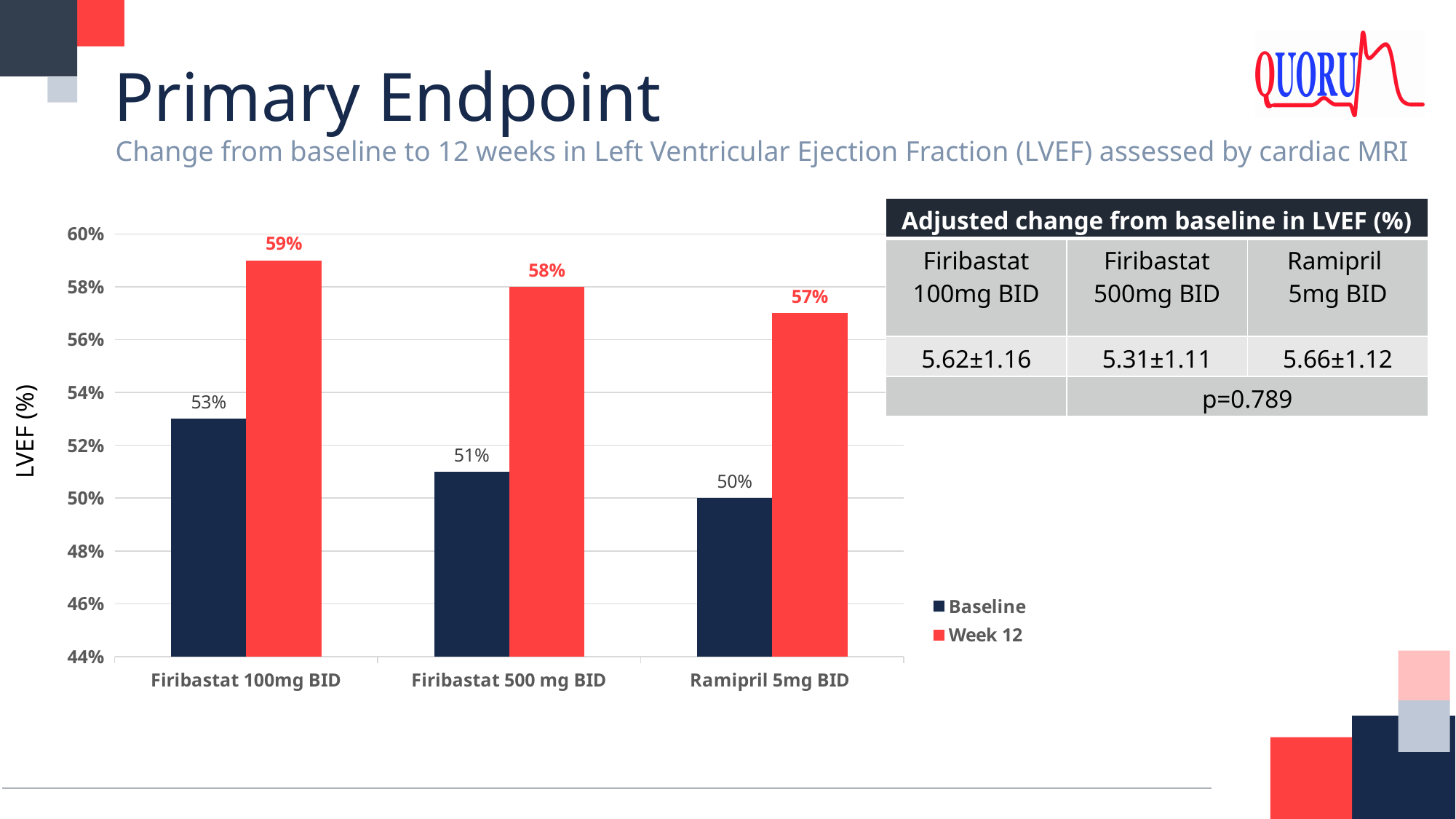
What is the label of the y axis of the chart? LVEF (%) What is the difference between the Week 12 and Baseline LVEF values for Firibastat 500 mg BID? 7% What is the Week 12 LVEF value for Firibastat 500 mg BID? 58% How many treatment groups are shown on the x axis of the chart? 3 Which is larger, the Baseline value for Firibastat 100mg BID or the Baseline value for Ramipril 5mg BID? Firibastat 100mg BID What kind of chart is shown on the slide? Bar chart Which group has the lowest Baseline LVEF value? Ramipril 5mg BID What is the Baseline LVEF value for Firibastat 100mg BID? 53% Is the Week 12 value for Ramipril 5mg BID greater or less than 56%? greater How many series does the chart legend list? 2 What is the Week 12 LVEF value for Ramipril 5mg BID? 57% Which group has the highest Week 12 LVEF value? Firibastat 100mg BID